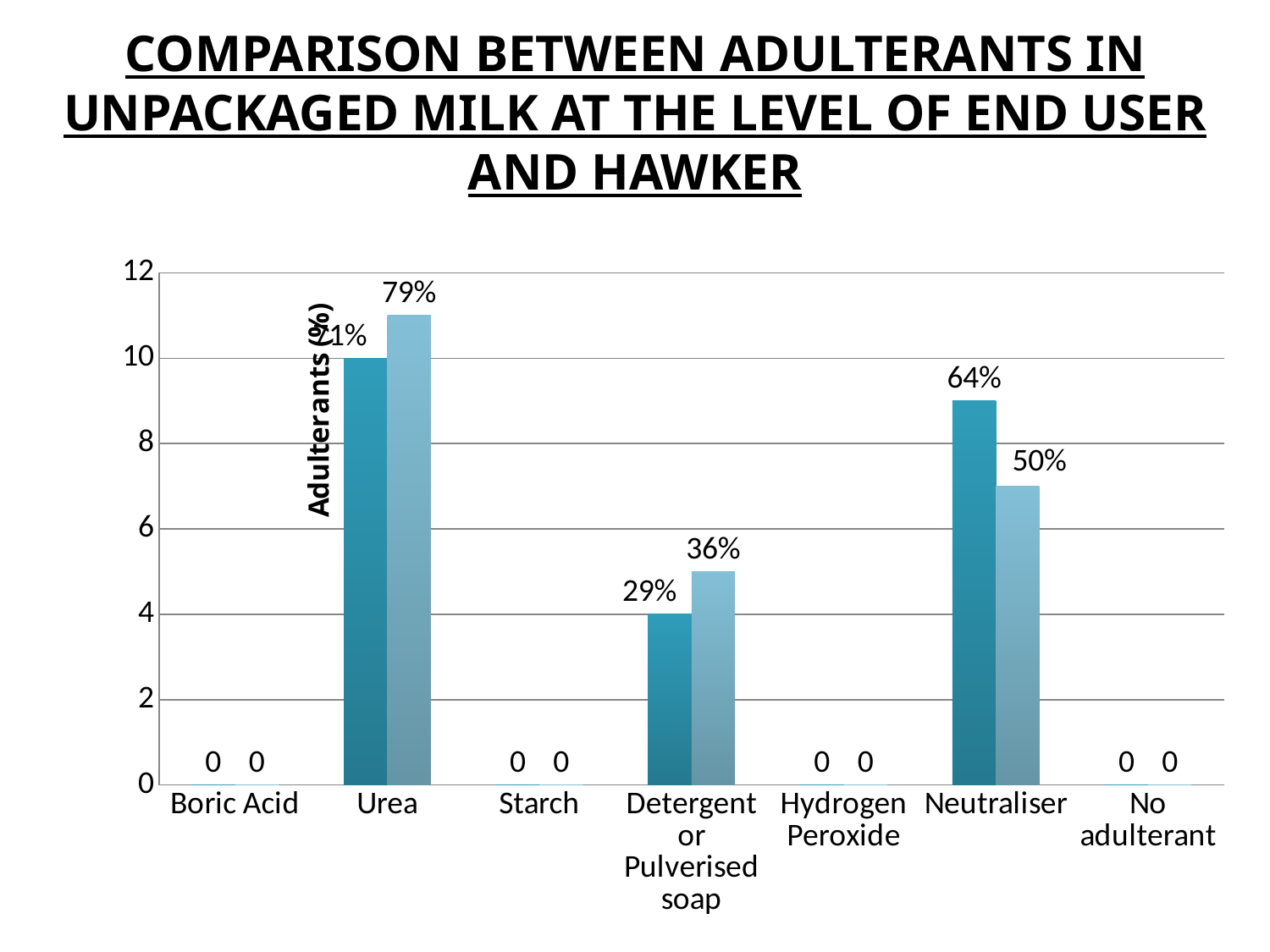
What is the difference between the two data labels for Neutraliser (64% and 50%)? 14 percentage points What is the data label on the darker (first) bar for Neutraliser? 64% What is the data label shown for Boric Acid? 0 Is the lighter (second) bar for Detergent or Pulverised soap greater or less than 6 on the y axis? less How many adulterant categories are shown on the x axis? 7 What is the data label on the lighter (second) bar for Detergent or Pulverised soap? 36% What kind of chart is shown on the slide? bar chart Which category has the tallest bars in the chart? Urea What is the data label on the lighter (second) bar for Urea? 79% What is the data label on the darker (first) bar for Detergent or Pulverised soap? 29% What is the data label on the lighter (second) bar for Neutraliser? 50% For Neutraliser, which bar is larger, the darker (first) bar or the lighter (second) bar? the darker (first) bar